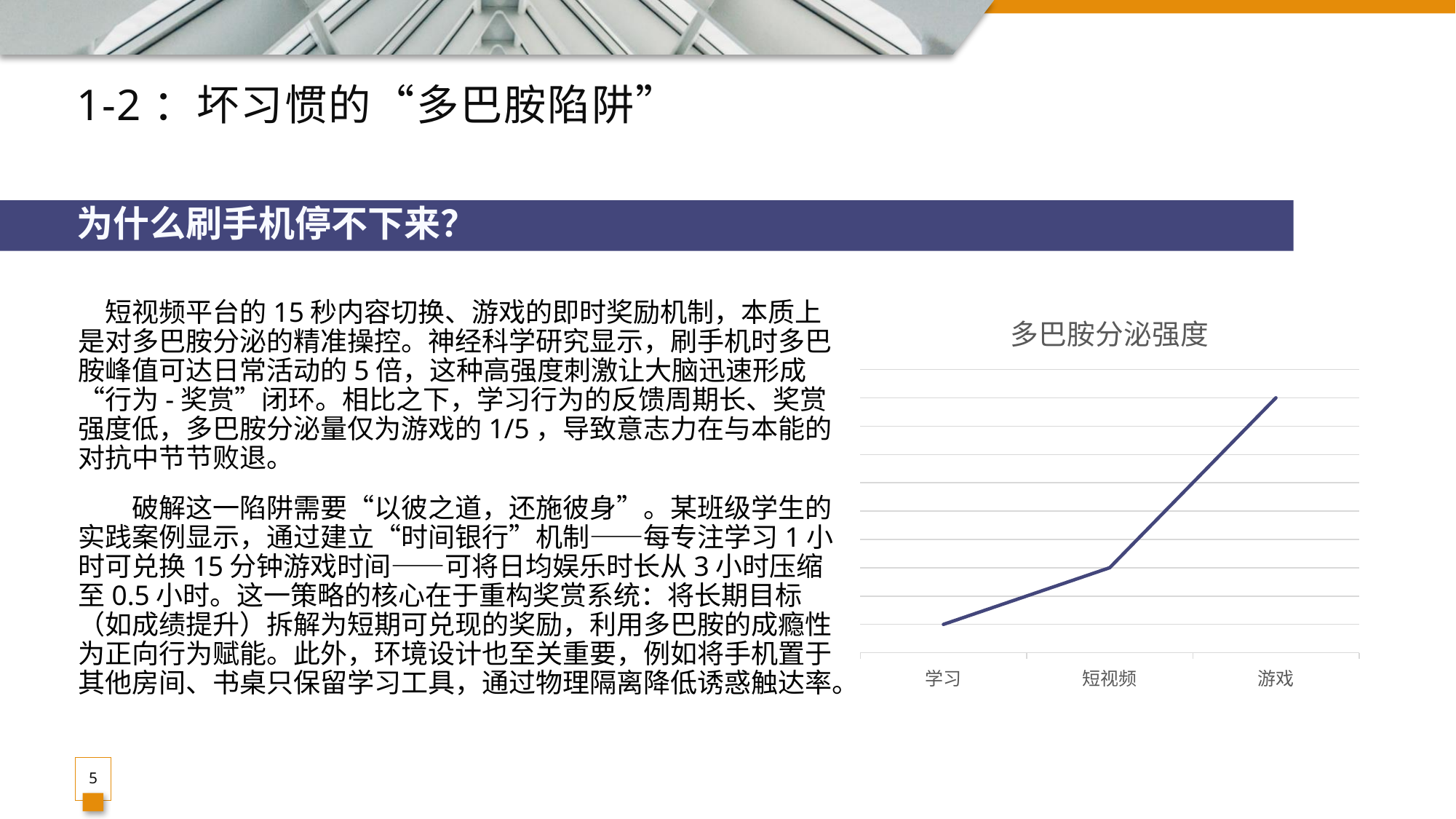
How many categories are plotted on the x axis of the chart? 3 What kind of chart is shown on the slide? line chart What is the title of the chart? 多巴胺分泌强度 Do the values rise or fall from 学习 to 游戏 along the x axis? rise What is the label of the first category on the x axis of the chart? 学习 Which category has the highest value in the chart? 游戏 Which category has the lowest value in the chart? 学习 Which has a lower value in the chart, 学习 or 短视频? 学习 Which has a higher value in the chart, 短视频 or 游戏? 游戏